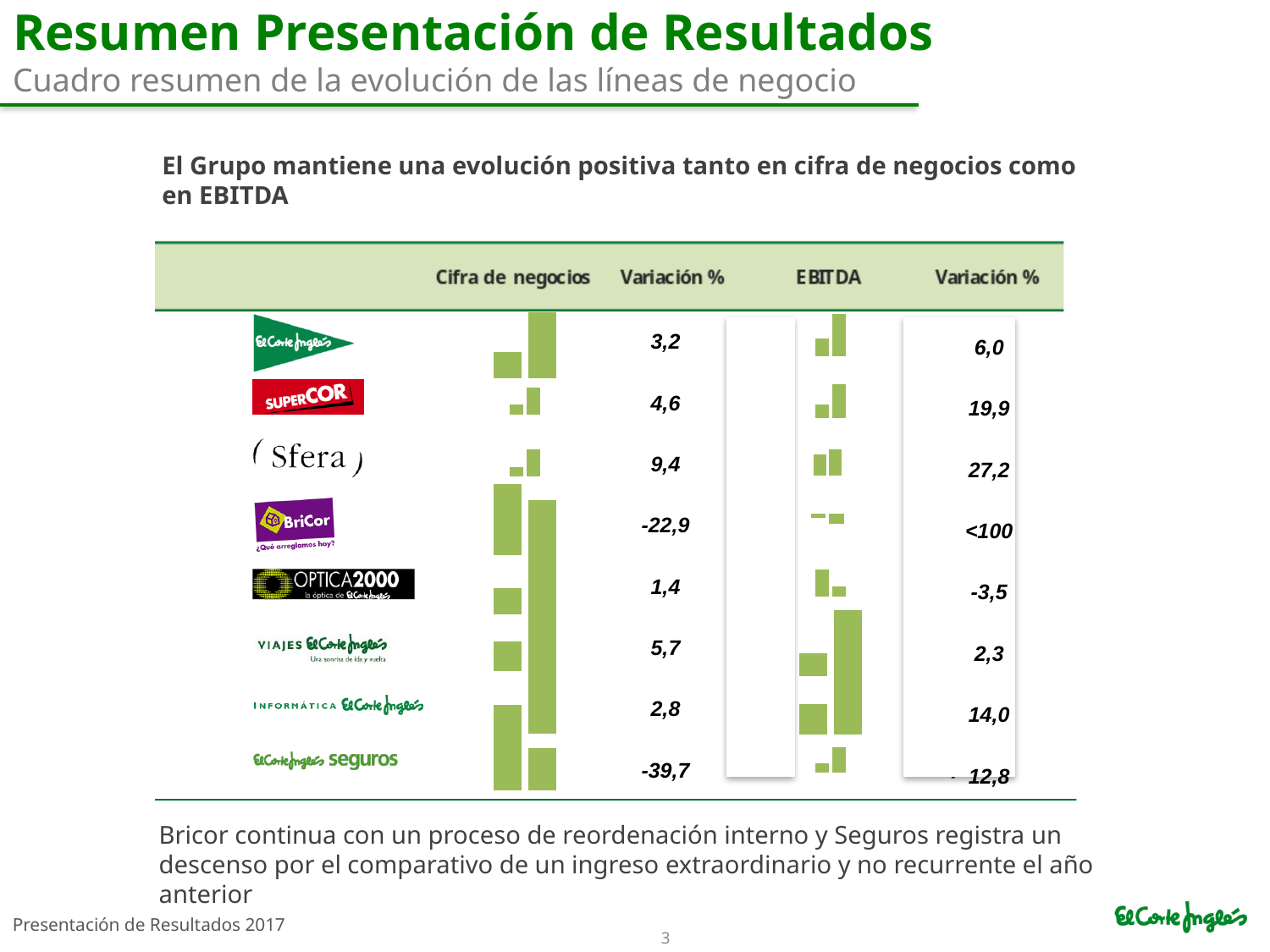
What is the Variación % of Cifra de negocios for Sfera? 9,4 What is the Variación % of EBITDA for Informática El Corte Inglés? 14,0 What kind of chart is used in the Cifra de negocios and EBITDA columns? Bar chart What is the Variación % of EBITDA for Optica 2000? -3,5 What is the Variación % of EBITDA for Supercor? 19,9 What is the Variación % of Cifra de negocios for Bricor? -22,9 Which has a larger Variación % in Cifra de negocios, Supercor or Viajes El Corte Inglés? Viajes El Corte Inglés How many business lines are listed in the table? 8 Which business line has the lowest Variación % in Cifra de negocios? Seguros Which business line has the highest Variación % in Cifra de negocios? Sfera What is the difference between the Cifra de negocios Variación % of Sfera and Supercor? 4,8 Which business line has the highest Variación % in EBITDA among those with a numeric value shown? Sfera